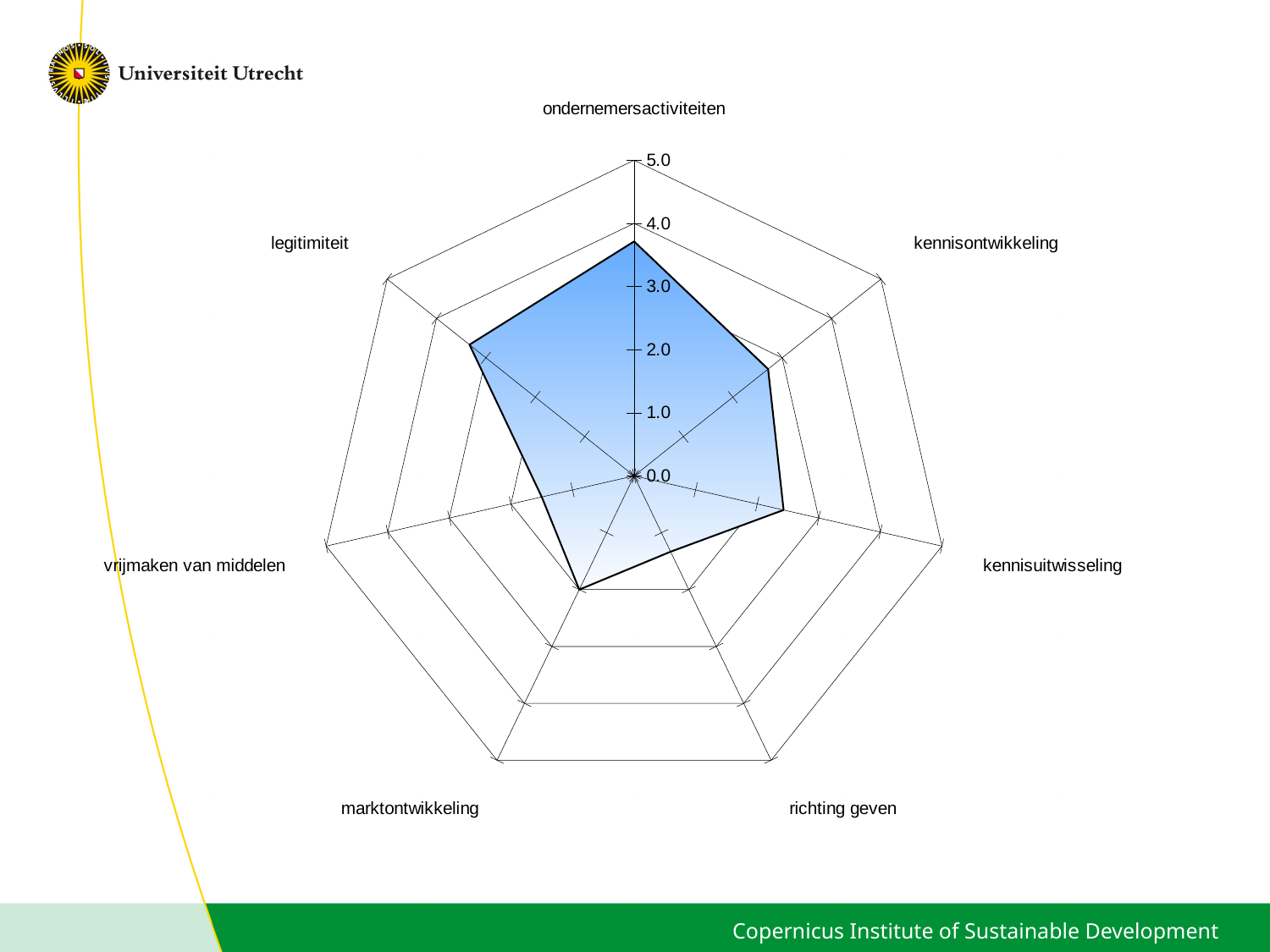
Is the value for richting geven greater or less than 2.0? less Is the value for legitimiteit greater or less than 3.0? greater Is the value for kennisontwikkeling greater or less than 2.0? greater How many categories (axes) does the radar chart have? 7 What is the maximum value shown on the radar chart's axis scale? 5.0 Which has a higher value, legitimiteit or marktontwikkeling? legitimiteit Which has a higher value, ondernemersactiviteiten or richting geven? ondernemersactiviteiten What kind of chart is shown on the slide? Radar chart Which category has the highest value in the radar chart? ondernemersactiviteiten